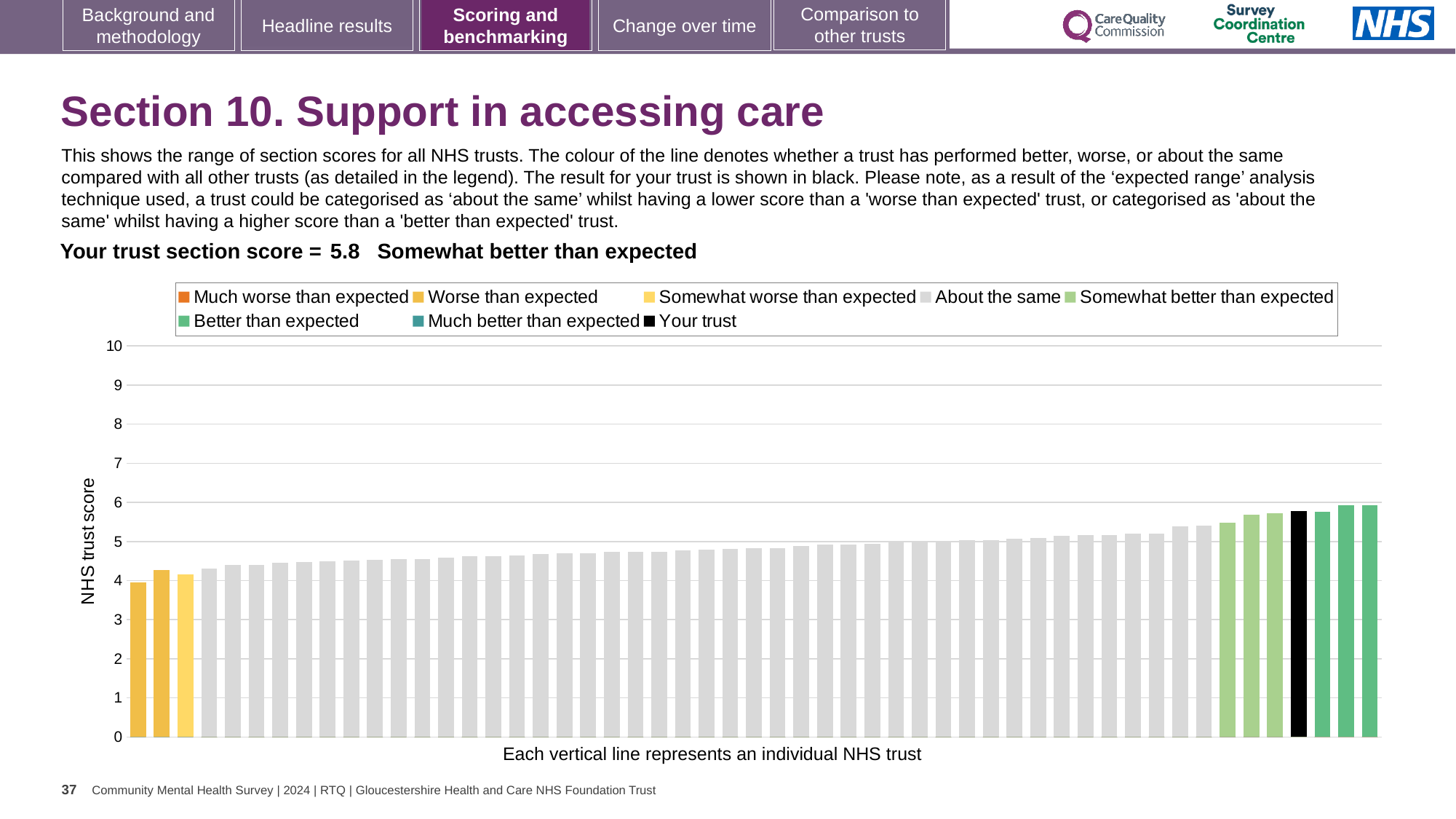
Do the bar values rise or fall from left to right along the x axis? rise What is the section score for your trust shown on the slide? 5.8 Is the value for your trust greater or less than 5? greater What is the label on the vertical axis of the chart? NHS trust score How is your trust's section score categorised according to the slide? Somewhat better than expected Is the value of the lowest bar in the chart greater or less than 5? less How many bars are coloured as 'Worse than expected'? 2 Is the value of the tallest bar in the chart greater or less than 7? less How many entries does the chart legend list? 8 Which legend category contains the tallest bar in the chart? Better than expected How many bars are coloured as 'Better than expected'? 3 What kind of chart is shown on the slide? Bar chart